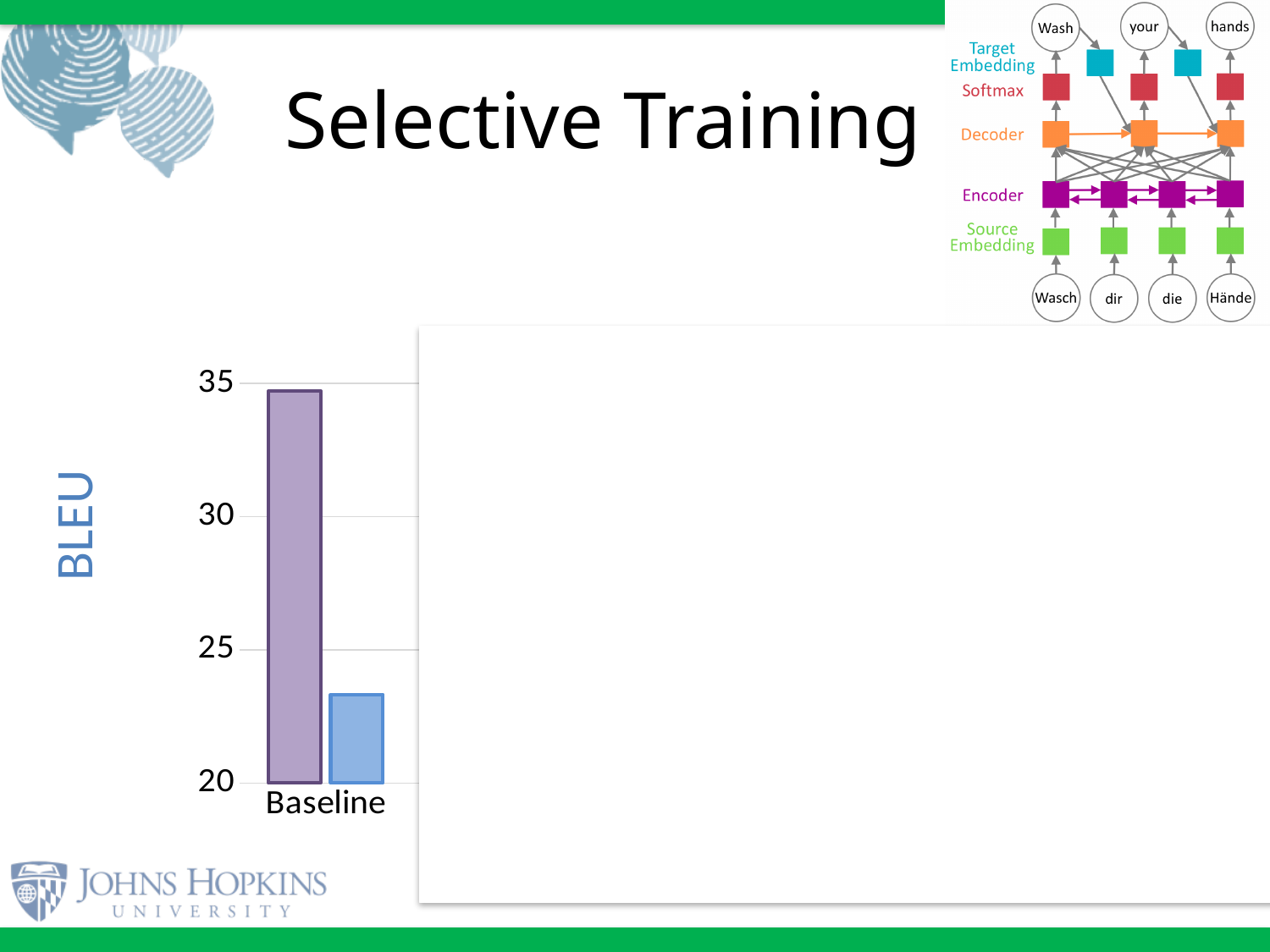
What is the label of the only category on the x axis? Baseline Which bar in the chart has the highest value? the purple bar for Baseline Is the value of the blue bar for Baseline greater or less than 20? greater Which bar for Baseline is taller, the purple bar or the blue bar? the purple bar Is the value of the blue bar for Baseline greater or less than 25? less What kind of chart is shown on the slide? bar chart Is the value of the purple bar for Baseline greater or less than 35? less How many categories are shown on the x axis of the chart? 1 What is the label of the y axis of the chart? BLEU Which bar in the chart has the lowest value? the blue bar for Baseline